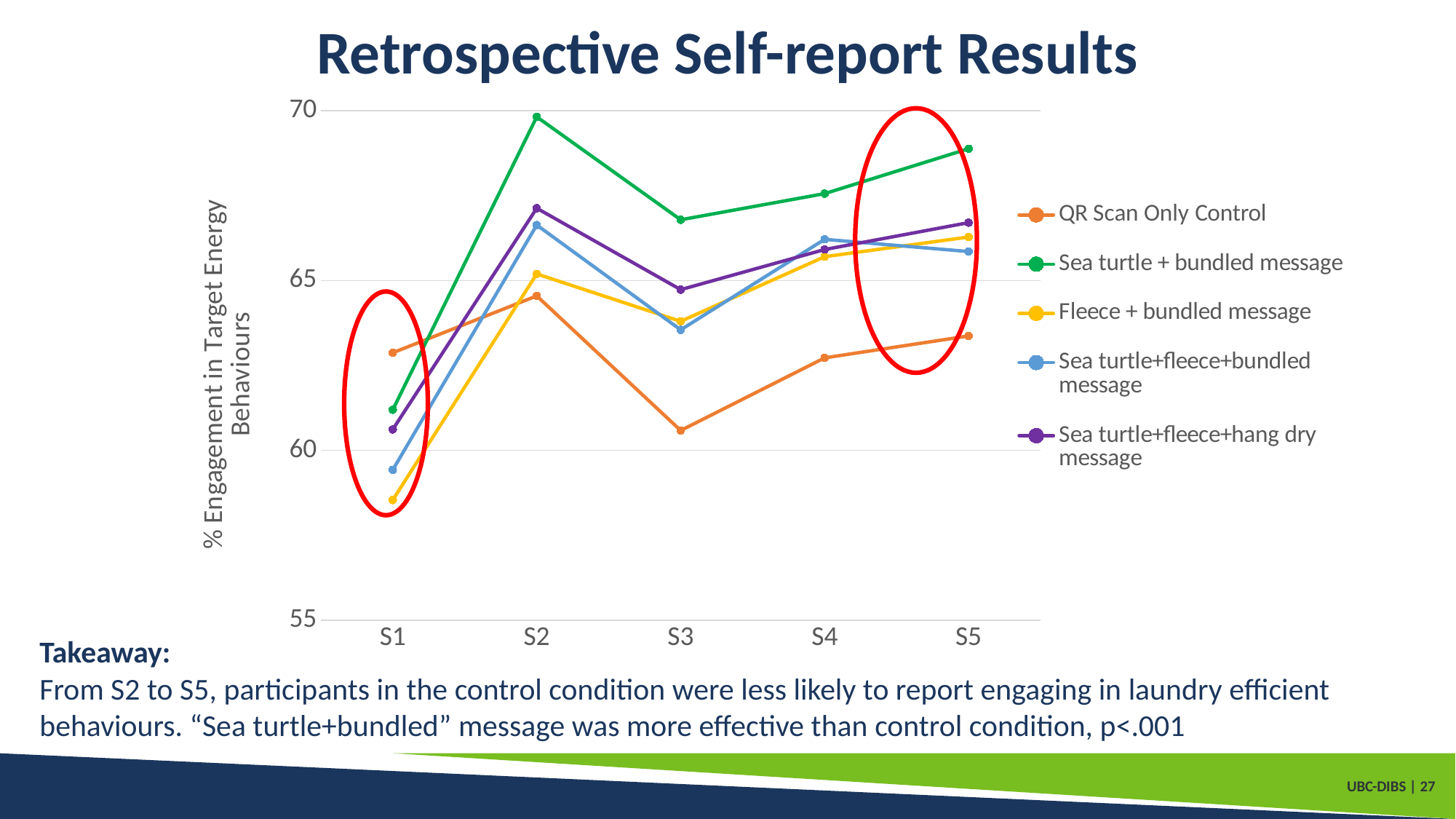
Which series has the lowest value at S3? QR Scan Only Control What is the label on the y axis? % Engagement in Target Energy Behaviours What kind of chart is shown on the slide? line chart At S5, which is larger: Sea turtle + bundled message or QR Scan Only Control? Sea turtle + bundled message Is the value for QR Scan Only Control at S3 greater or less than 65? less Which series has the lowest value at S1? Fleece + bundled message How many series does the legend list? 5 How many time points (S1 to S5) are plotted along the x axis? 5 Is the value for Fleece + bundled message at S1 greater or less than 60? less Is the value for Sea turtle + bundled message at S1 greater or less than 65? less Which series has the highest value at S2? Sea turtle + bundled message Does the QR Scan Only Control line rise or fall from S2 to S3? fall